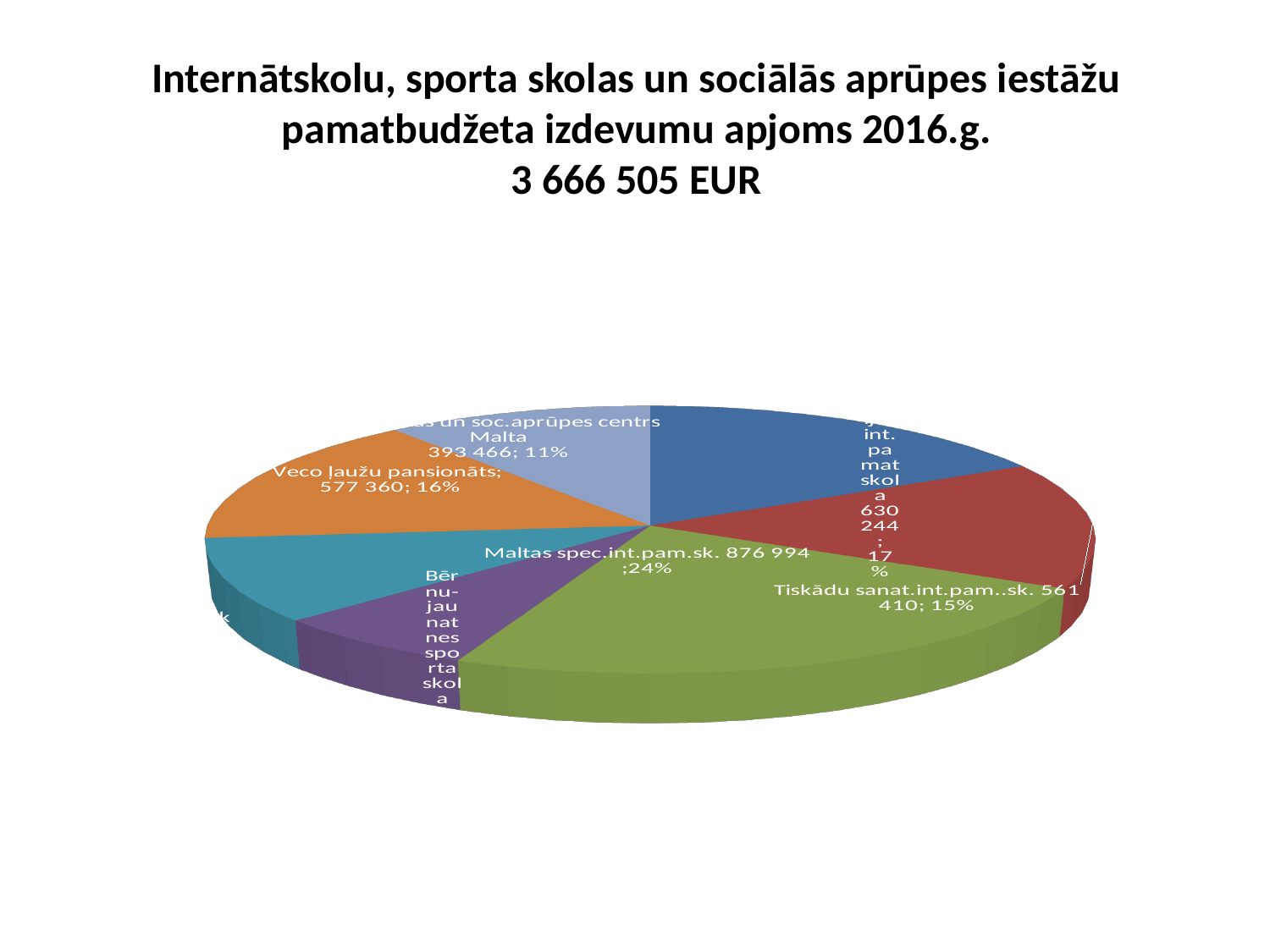
Which slice is the largest in the pie chart? Maltas spec.int.pam.sk. How many slices does the pie chart have? 7 What percentage is shown for Veco ļaužu pansionāts? 16% What is the value shown for Maltas spec.int.pam.sk.? 876 994 What total amount in EUR is stated in the chart title? 3 666 505 EUR What percentage is shown for the soc.aprūpes centrs Malta slice? 11% What is the value shown for Veco ļaužu pansionāts? 577 360 What type of chart is shown on the slide? pie chart What share of the pie does Maltas spec.int.pam.sk. represent? 24% What is the value shown for Tiskādu sanat.int.pam..sk.? 561 410 What is the difference between the values for Maltas spec.int.pam.sk. and Tiskādu sanat.int.pam..sk.? 315 584 Which is larger: the value for Veco ļaužu pansionāts or for Tiskādu sanat.int.pam..sk.? Veco ļaužu pansionāts